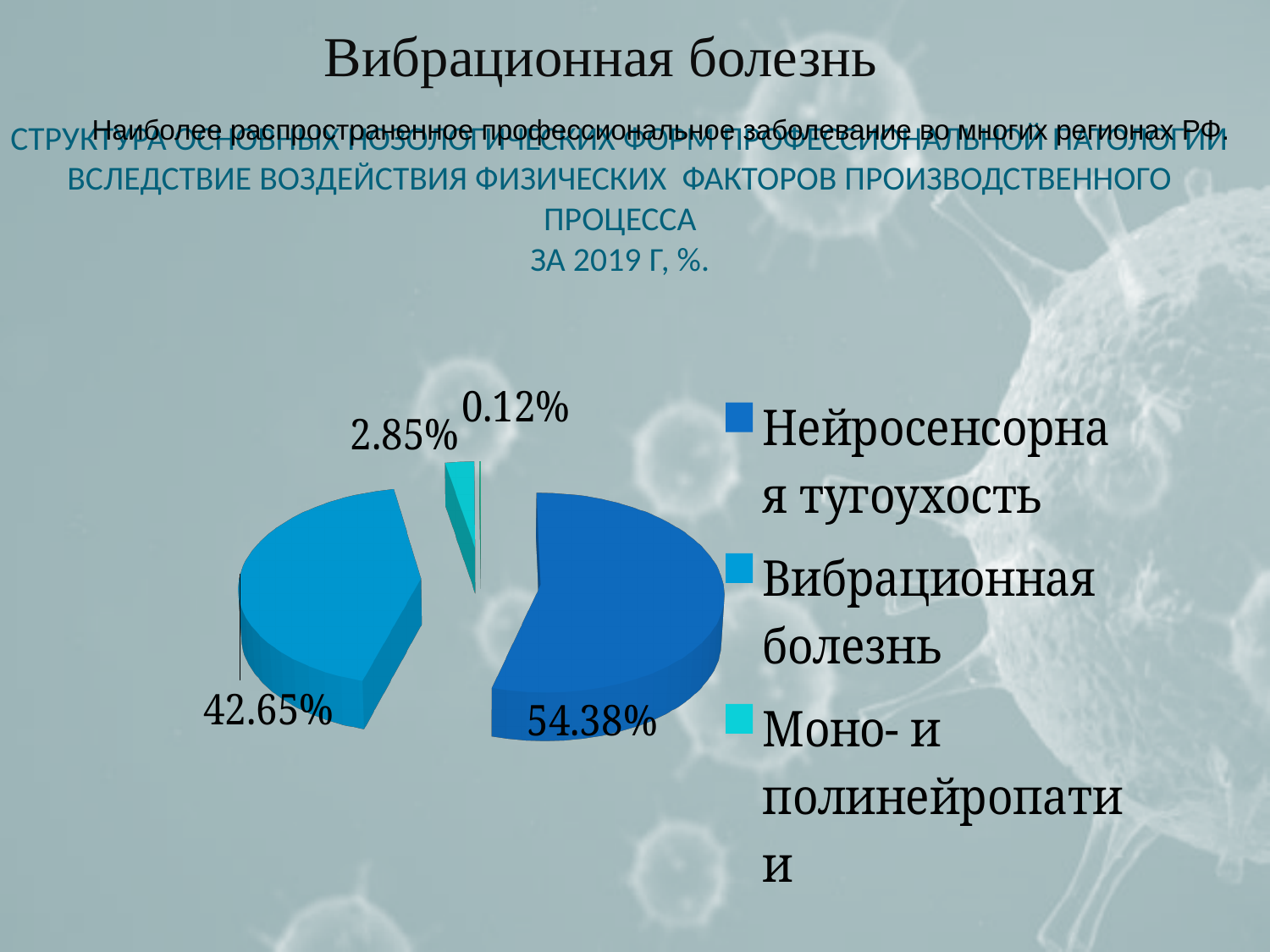
What kind of chart is shown on the slide? Pie chart How many entries does the legend of the pie chart list? 3 What percentage does the pie chart show for Моно- и полинейропатии? 2.85% Which category has the largest share of the pie chart? Нейросенсорная тугоухость What percentage does the pie chart show for Нейросенсорная тугоухость? 54.38% Which is larger: the share of Вибрационная болезнь or the share of Моно- и полинейропатии? Вибрационная болезнь For which year does the chart title say the data is given? 2019 What percentage does the pie chart show for Вибрационная болезнь? 42.65% What is the difference between the shares of Нейросенсорная тугоухость and Вибрационная болезнь? 11.73% What is the smallest percentage value labelled on the pie chart? 0.12% What colour is the slice for Моно- и полинейропатии in the pie chart? Cyan (light blue) How many percentage data labels are shown on the pie chart? 4